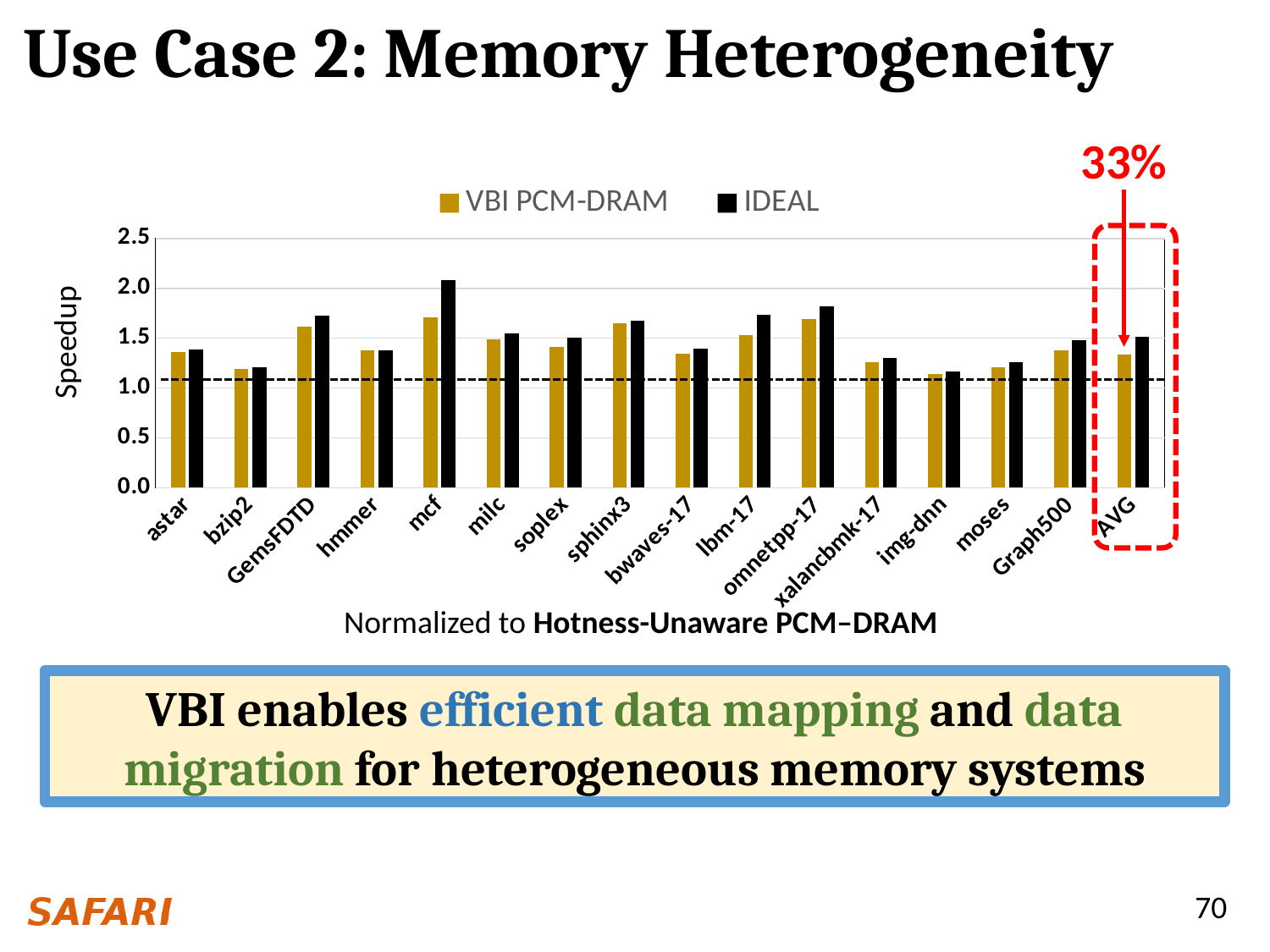
Is the IDEAL value for mcf greater or less than 2.0? greater What kind of chart is shown on the slide? bar chart Is the VBI PCM-DRAM value for bzip2 greater or less than 1.5? less Which is larger for mcf, the VBI PCM-DRAM bar or the IDEAL bar? IDEAL Is the VBI PCM-DRAM value for omnetpp-17 greater or less than 1.5? greater How many series does the legend list? 2 What is the label on the y axis? Speedup Which category has a larger VBI PCM-DRAM speedup, GemsFDTD or xalancbmk-17? GemsFDTD What percentage is annotated in red above the AVG bars? 33% Which category has the lowest VBI PCM-DRAM speedup? img-dnn Which category has the highest IDEAL speedup? mcf How many categories are shown along the x axis? 16